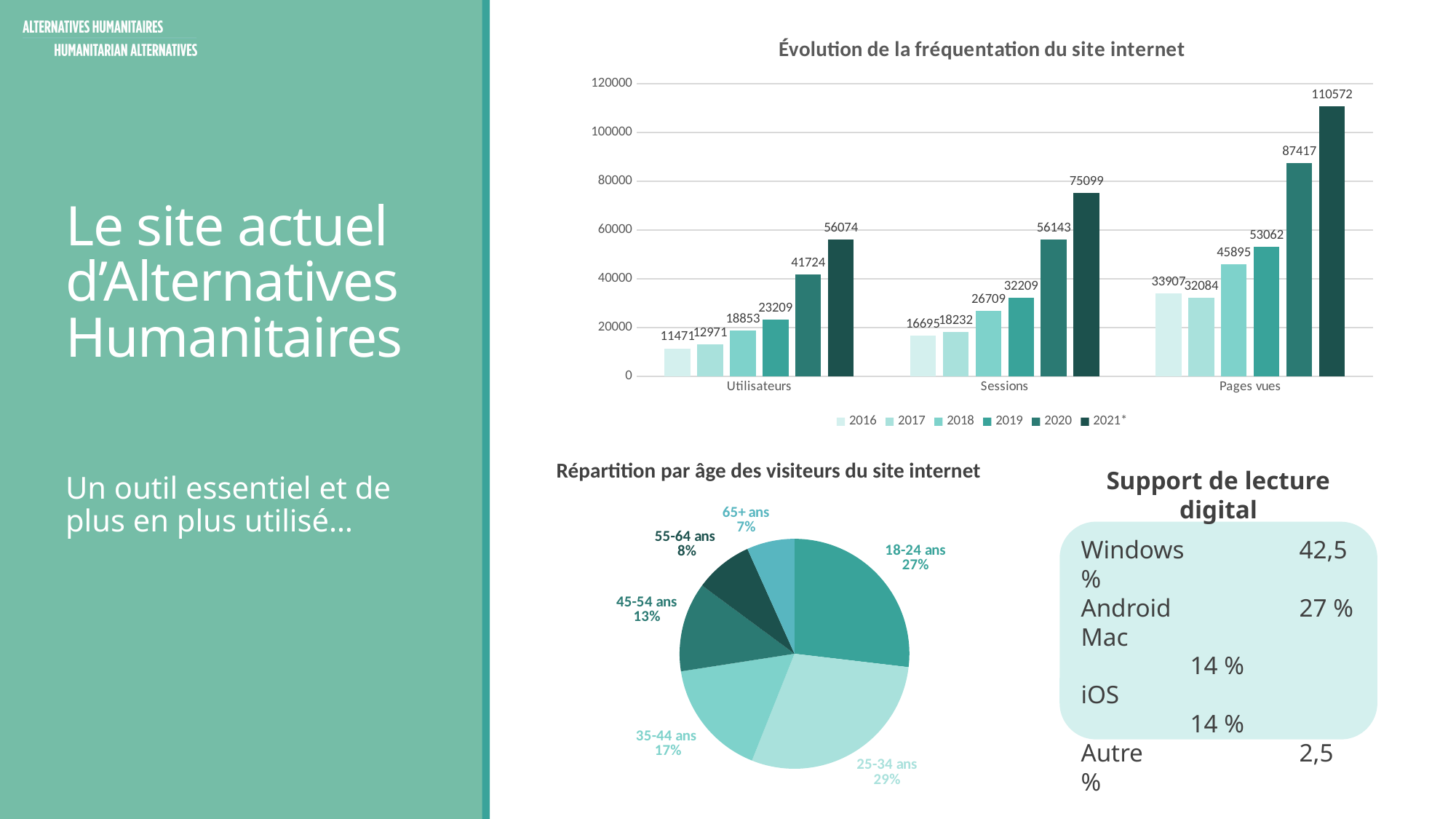
In the chart 'Évolution de la fréquentation du site internet', which is larger: Pages vues in 2016 or Pages vues in 2017? Pages vues in 2016 In the pie chart 'Répartition par âge des visiteurs du site internet', which age group has the smallest share? 65+ ans In the chart 'Évolution de la fréquentation du site internet', do the Utilisateurs values rise or fall from 2016 to 2021*? Rise In the chart 'Évolution de la fréquentation du site internet', which year has the highest value for Pages vues? 2021* How many age groups are shown in the pie chart 'Répartition par âge des visiteurs du site internet'? 6 What kind of chart is 'Évolution de la fréquentation du site internet'? Bar chart In the chart 'Évolution de la fréquentation du site internet', what is the value for Utilisateurs in 2021*? 56074 In the chart 'Évolution de la fréquentation du site internet', what is the difference between Sessions in 2021* and Sessions in 2020? 18956 In the chart 'Évolution de la fréquentation du site internet', what is the value for Sessions in 2019? 32209 In the chart 'Évolution de la fréquentation du site internet', what is the value for Pages vues in 2016? 33907 In the pie chart 'Répartition par âge des visiteurs du site internet', what share do the 25-34 ans visitors represent? 29% How many series does the legend of the chart 'Évolution de la fréquentation du site internet' list? 6